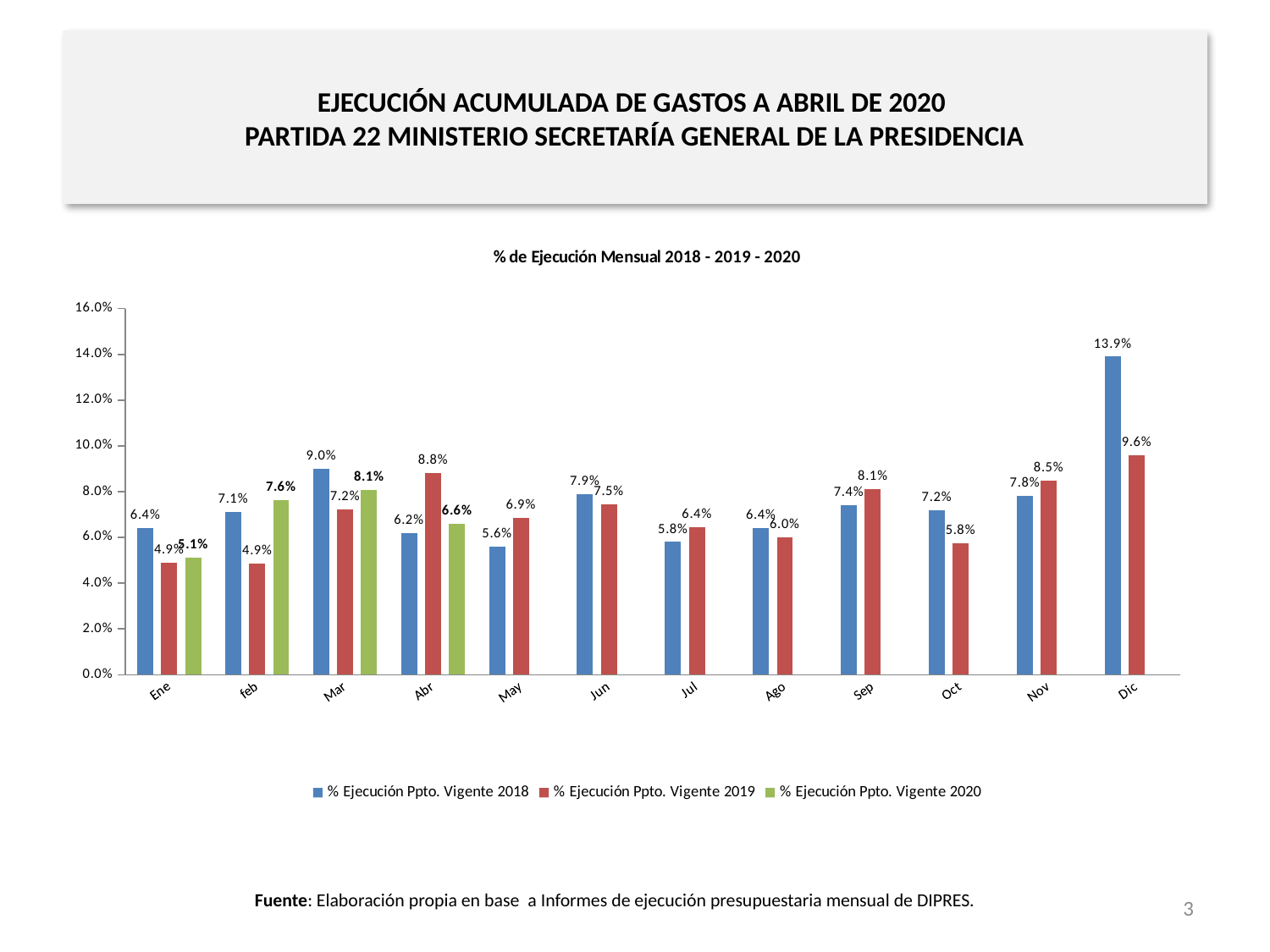
What is the value for % Ejecución Ppto. Vigente 2018 in Dic? 13.9% What kind of chart is shown on the slide? bar chart Which month has the lowest value for % Ejecución Ppto. Vigente 2018? May What is the value for % Ejecución Ppto. Vigente 2019 in Abr? 8.8% How many series does the legend list? 3 What is the difference between the 2018 and 2019 values in Dic? 4.3% What is the value for % Ejecución Ppto. Vigente 2020 in Mar? 8.1% Which month has the highest value for % Ejecución Ppto. Vigente 2018? Dic How many months are shown on the x axis? 12 Which is larger in Abr: the 2018 value or the 2019 value? 2019 What is the title of the chart? % de Ejecución Mensual 2018 - 2019 - 2020 Is the value for % Ejecución Ppto. Vigente 2018 in Dic greater or less than 12.0%? greater